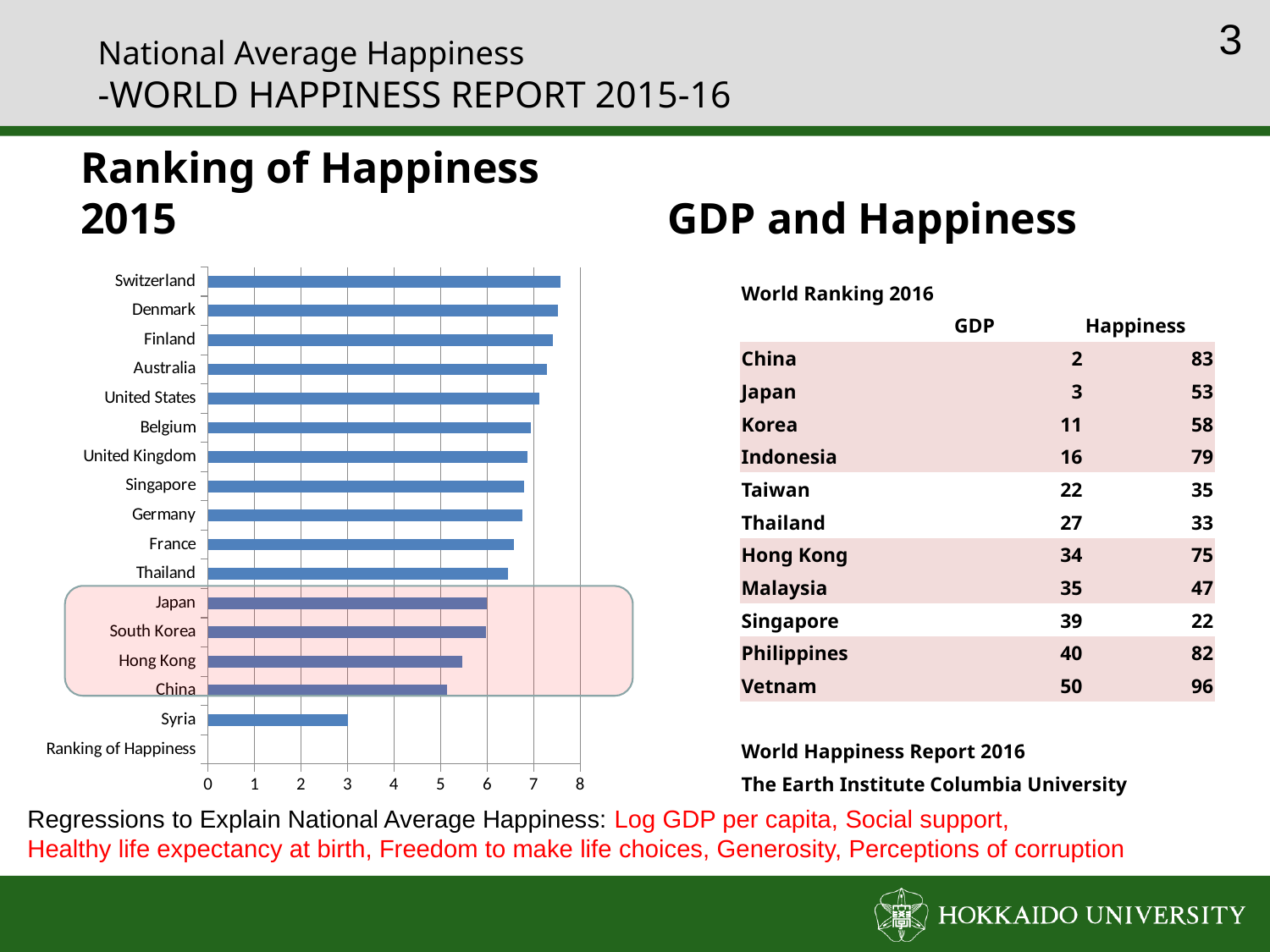
Which has a higher happiness value, Finland or Thailand? Finland Is the value for Switzerland greater or less than 7? greater Which country is listed at the top of the chart with the longest bar? Switzerland What kind of chart is shown on the slide? Bar chart Is the value for Thailand greater or less than 6? greater Which has a higher happiness value, Japan or China? Japan What is the title of the chart on the left of the slide? Ranking of Happiness 2015 Do the bar values rise or fall going down the list of countries from Switzerland to Syria? Fall Which country has the lowest happiness value in the chart? Syria Is the value for Hong Kong greater or less than 6? less